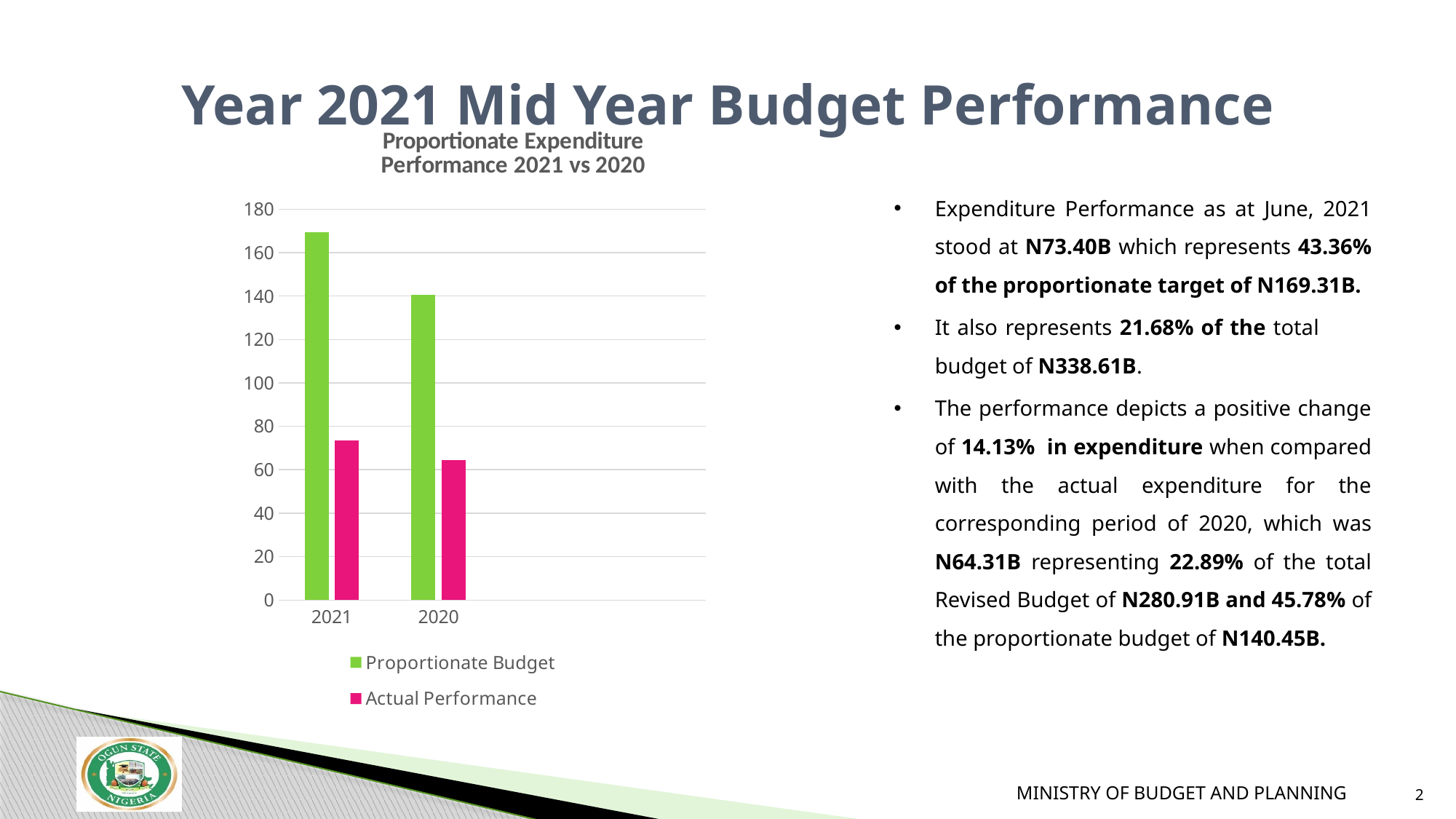
Is the Proportionate Budget value for 2020 greater or less than 120? greater What kind of chart is shown on the slide? bar chart Which series is shown in green in the chart? Proportionate Budget Which year has the higher Actual Performance bar? 2021 Which bar in the chart is the lowest? Actual Performance for 2020 What is the title of the chart? Proportionate Expenditure Performance 2021 vs 2020 Is the Actual Performance value for 2021 greater or less than 80? less Which year has the higher Proportionate Budget bar? 2021 Is the Actual Performance value for 2020 greater or less than 60? greater How many categories are shown on the x axis of the chart? 2 How many series does the chart legend list? 2